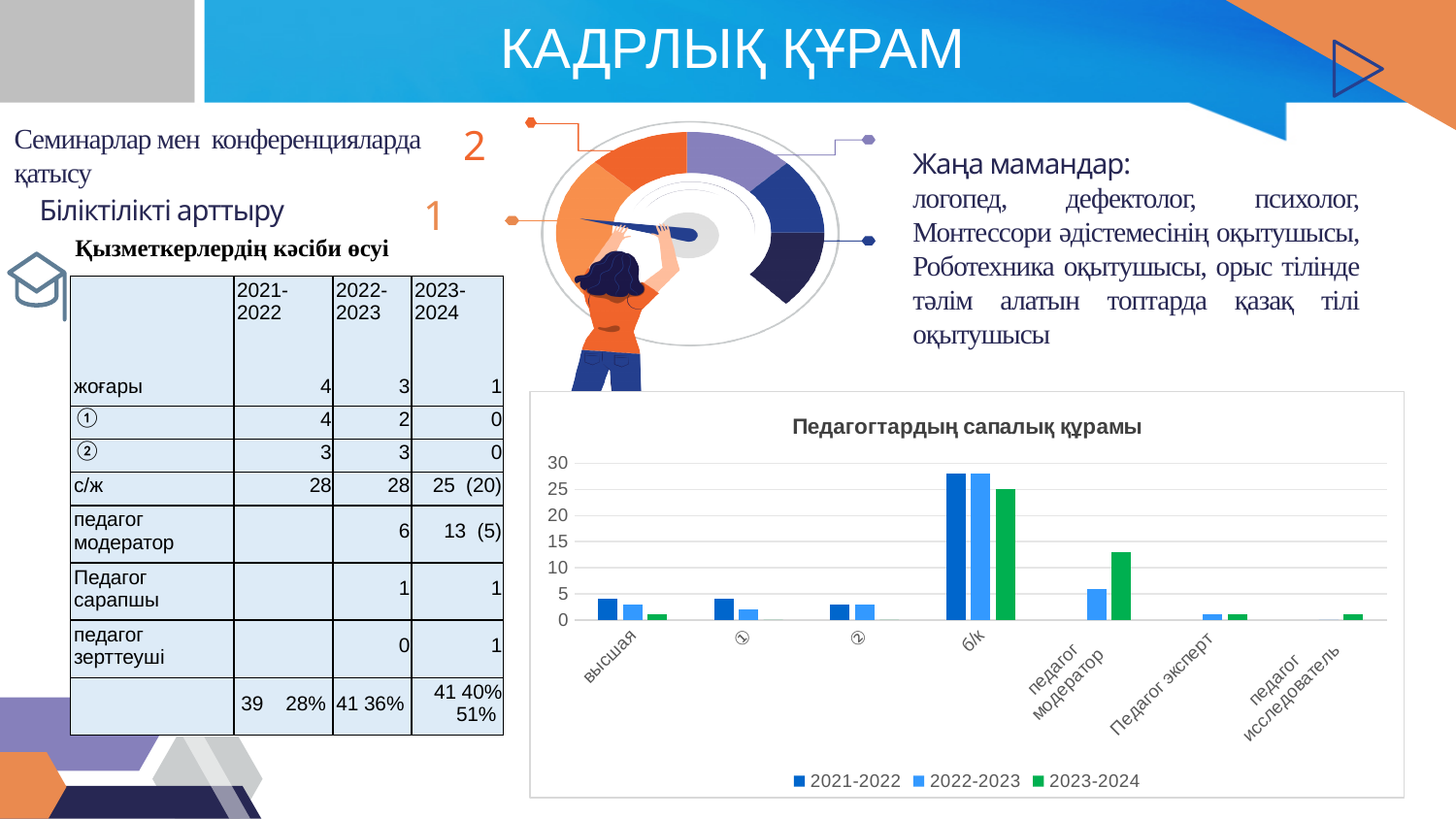
In the "Педагогтардың сапалық құрамы" chart, is the 2021-2022 value for б/к greater or less than 25? greater How many series does the legend of the "Педагогтардың сапалық құрамы" chart list? 3 In the "Педагогтардың сапалық құрамы" chart, is the 2022-2023 value for педагог модератор greater or less than 10? less In the "Педагогтардың сапалық құрамы" chart, what colour represents the 2023-2024 series? green What kind of chart is shown under the title "Педагогтардың сапалық құрамы"? bar chart In the "Педагогтардың сапалық құрамы" chart, which category has the tallest bar for the 2023-2024 series? б/к How many categories are shown on the x axis of the "Педагогтардың сапалық құрамы" chart? 7 In the "Педагогтардың сапалық құрамы" chart, is the 2023-2024 value for б/к greater or less than 20? greater In the "Педагогтардың сапалық құрамы" chart, which series has the larger value for педагог модератор: 2022-2023 or 2023-2024? 2023-2024 In the "Педагогтардың сапалық құрамы" chart, which category has the highest value for the 2021-2022 series? б/к In the "Педагогтардың сапалық құрамы" chart, which series has the larger value for высшая: 2021-2022 or 2023-2024? 2021-2022